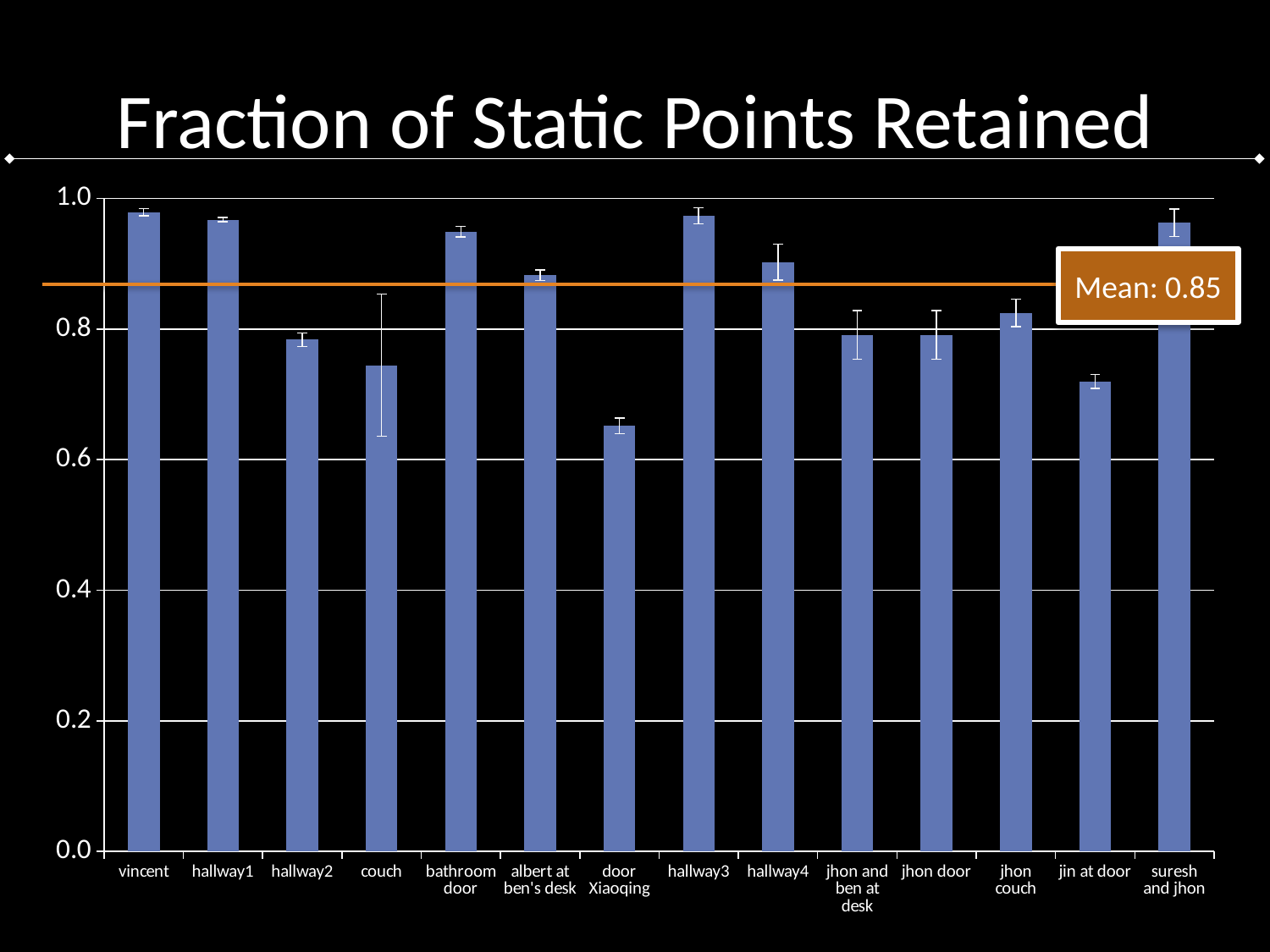
Is the value for hallway3 greater or less than 0.8? greater Which has a higher value, vincent or door Xiaoqing? vincent Is the value for door Xiaoqing greater or less than 0.8? less Is the value for vincent greater or less than 0.8? greater What kind of chart is shown on the slide? bar chart How many categories are shown on the x axis? 14 What is the title of the chart? Fraction of Static Points Retained What mean value is labelled on the chart? 0.85 Which has a higher value, bathroom door or couch? bathroom door Which category has the lowest fraction of static points retained? door Xiaoqing